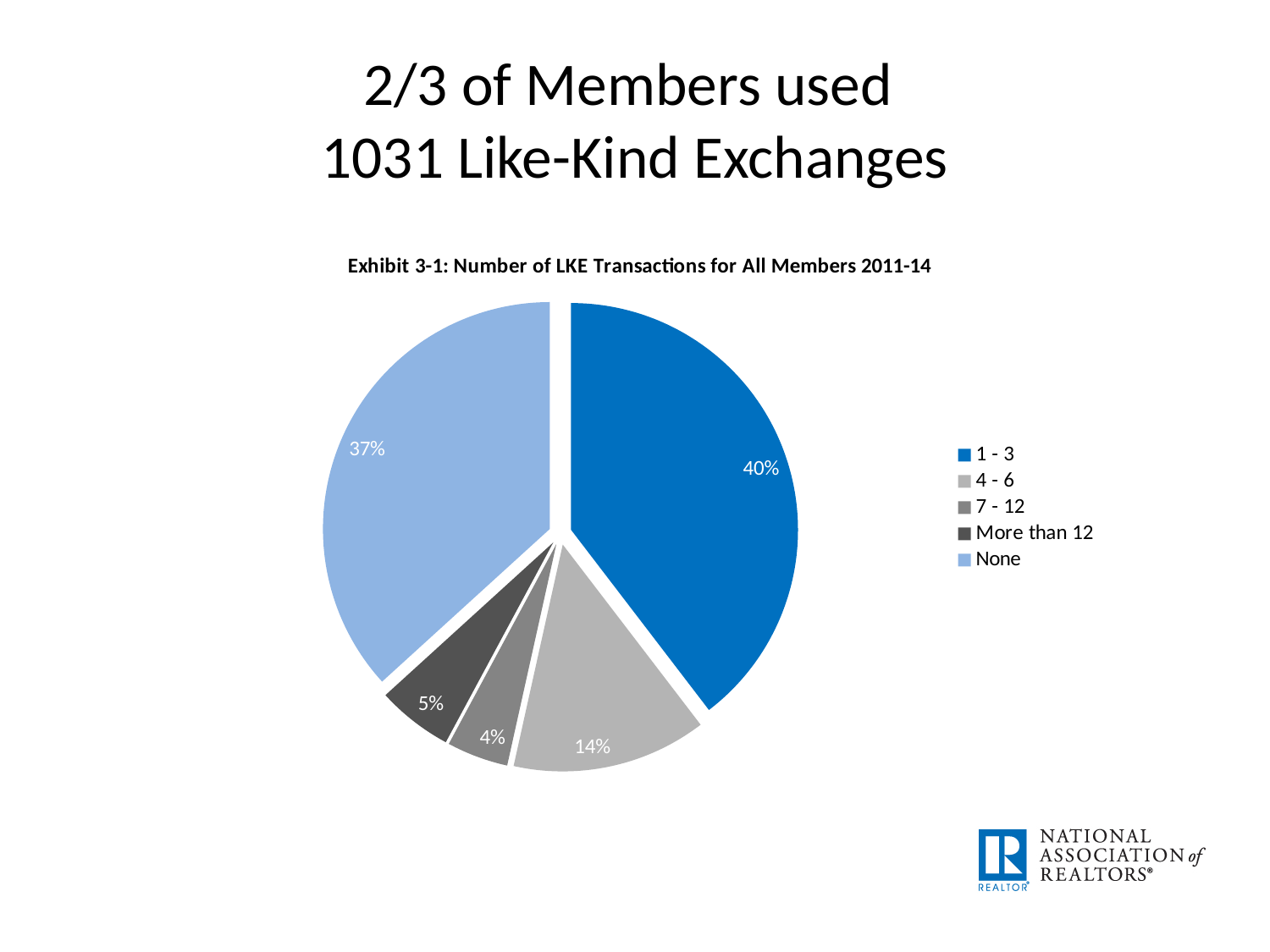
Which category has the largest slice of the pie? 1 - 3 What kind of chart is shown on the slide? Pie chart Which category has the smallest slice of the pie? 7 - 12 What is the title of the chart? Exhibit 3-1: Number of LKE Transactions for All Members 2011-14 What share of members had 7 - 12 LKE transactions? 4% What share of members had More than 12 LKE transactions? 5% What is the difference in percentage points between the 1 - 3 slice and the None slice? 3 percentage points What share of members had no LKE transactions (None)? 37% How many categories does the legend list? 5 Which is larger, the 4 - 6 slice or the More than 12 slice? 4 - 6